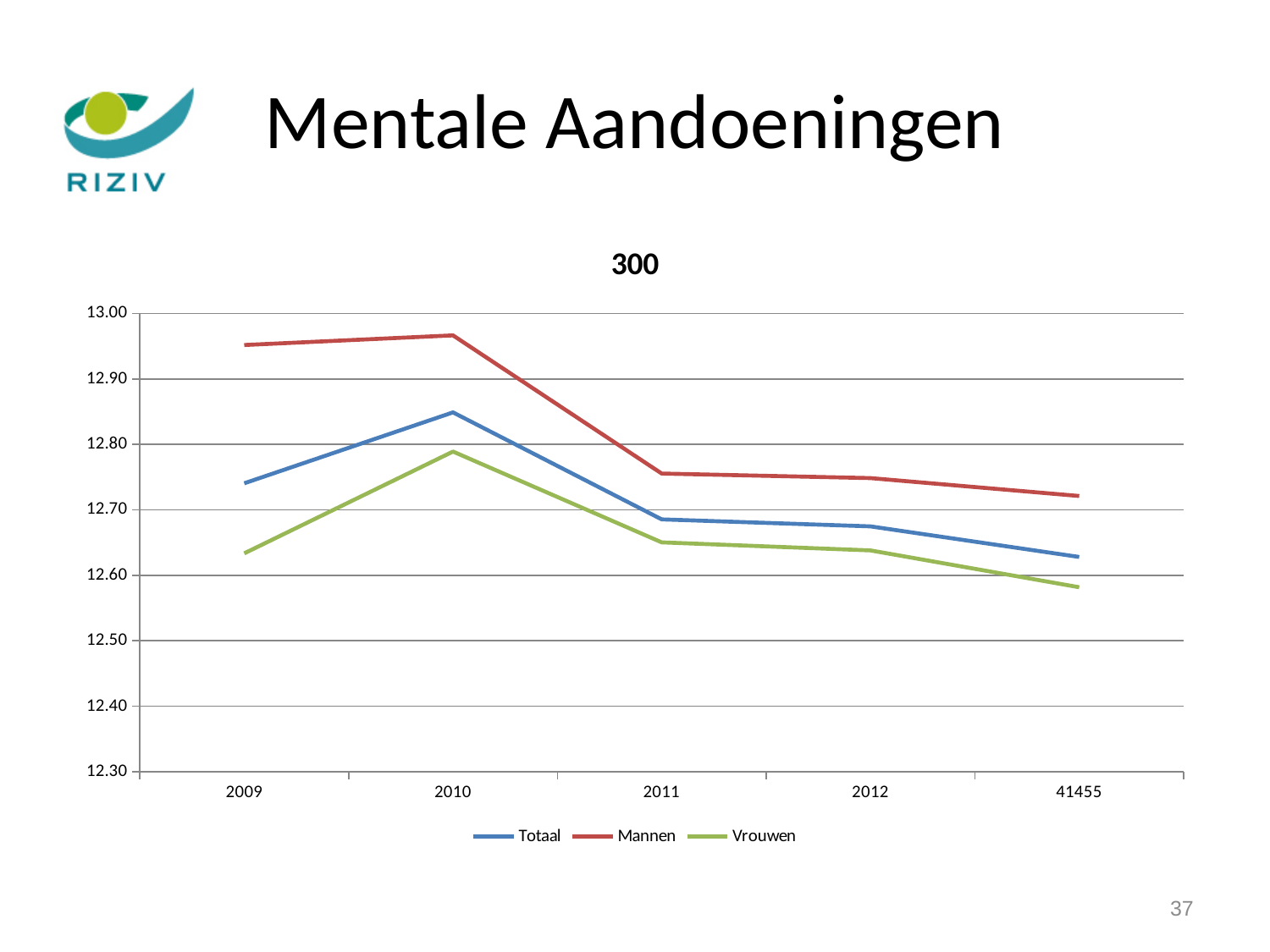
How many series does the legend list? 3 How many points are plotted along the x axis for each series? 5 What is the title of the chart? 300 Is the value for Vrouwen at 41455 greater or less than 12.60? less Which series is shown in red in the legend? Mannen Is the value for Mannen in 2009 greater or less than 12.90? greater What kind of chart is shown on the slide? line chart Which series has the highest values across all years? Mannen In which year does the Mannen series reach its highest value? 2010 Which series has the lowest values across all years? Vrouwen Is the value for Totaal in 2010 greater or less than 12.80? greater Do the values of the Totaal series rise or fall from 2010 to 41455? fall